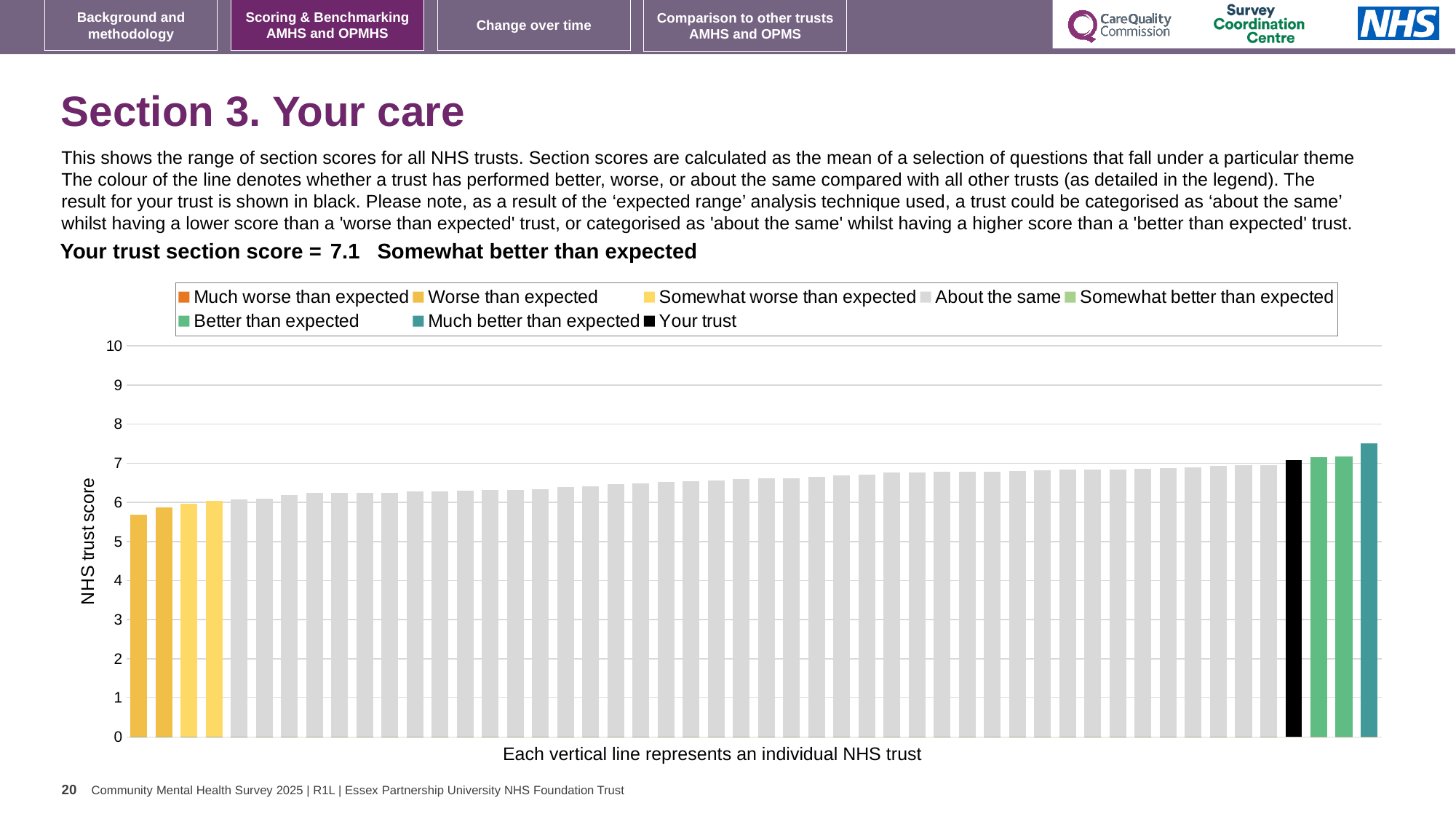
What colour is the bar for Your trust? black What is the section score for your trust shown on the slide? 7.1 How many bars are coloured as 'Much better than expected'? 1 What is the label on the vertical axis of the chart? NHS trust score What kind of chart is shown on the slide? bar chart How many bars are coloured as 'Better than expected'? 2 Is the value of the tallest bar greater or less than 8? less Is the value for Your trust greater or less than 7? greater How many entries does the chart legend list? 8 Which is higher: the Your trust bar or the tallest bar on the far right? the tallest bar on the far right Is the value of the lowest bar greater or less than 6? less Do the bar values rise or fall from left to right along the x axis? rise